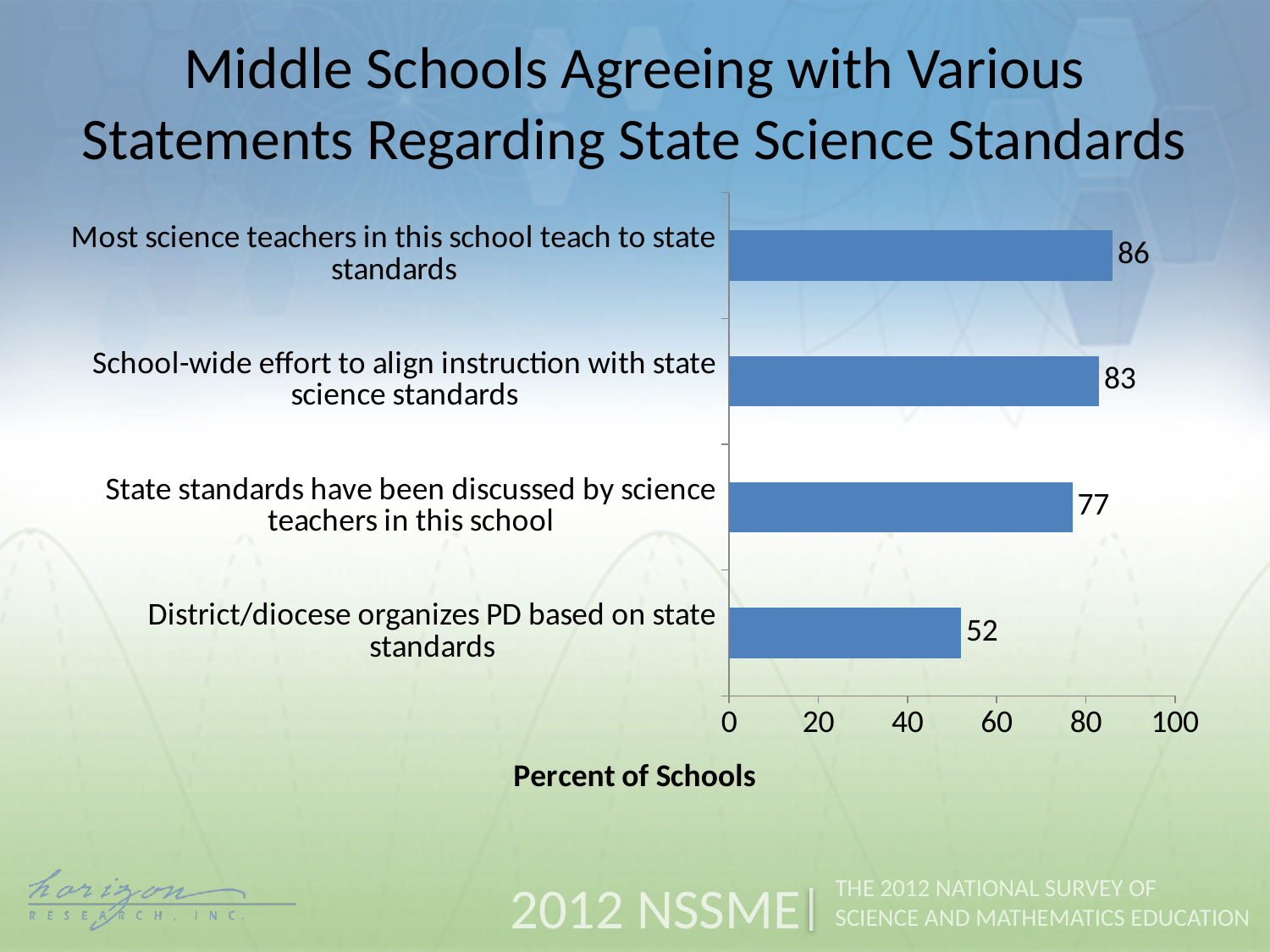
What percent of middle schools agree that most science teachers in this school teach to state standards? 86 What kind of chart is shown on the slide? bar chart Which statement has the lowest percent of schools agreeing? District/diocese organizes PD based on state standards How many statements are shown in the chart? 4 What is the title of the chart? Middle Schools Agreeing with Various Statements Regarding State Science Standards Is the value for "District/diocese organizes PD based on state standards" greater or less than 60? less What is the value for "District/diocese organizes PD based on state standards"? 52 Which statement has the highest percent of schools agreeing? Most science teachers in this school teach to state standards What is the label of the horizontal axis? Percent of Schools What is the value for "State standards have been discussed by science teachers in this school"? 77 What is the difference between the values for "School-wide effort to align instruction with state science standards" and "District/diocese organizes PD based on state standards"? 31 Which is larger: the value for "School-wide effort to align instruction with state science standards" or "State standards have been discussed by science teachers in this school"? School-wide effort to align instruction with state science standards